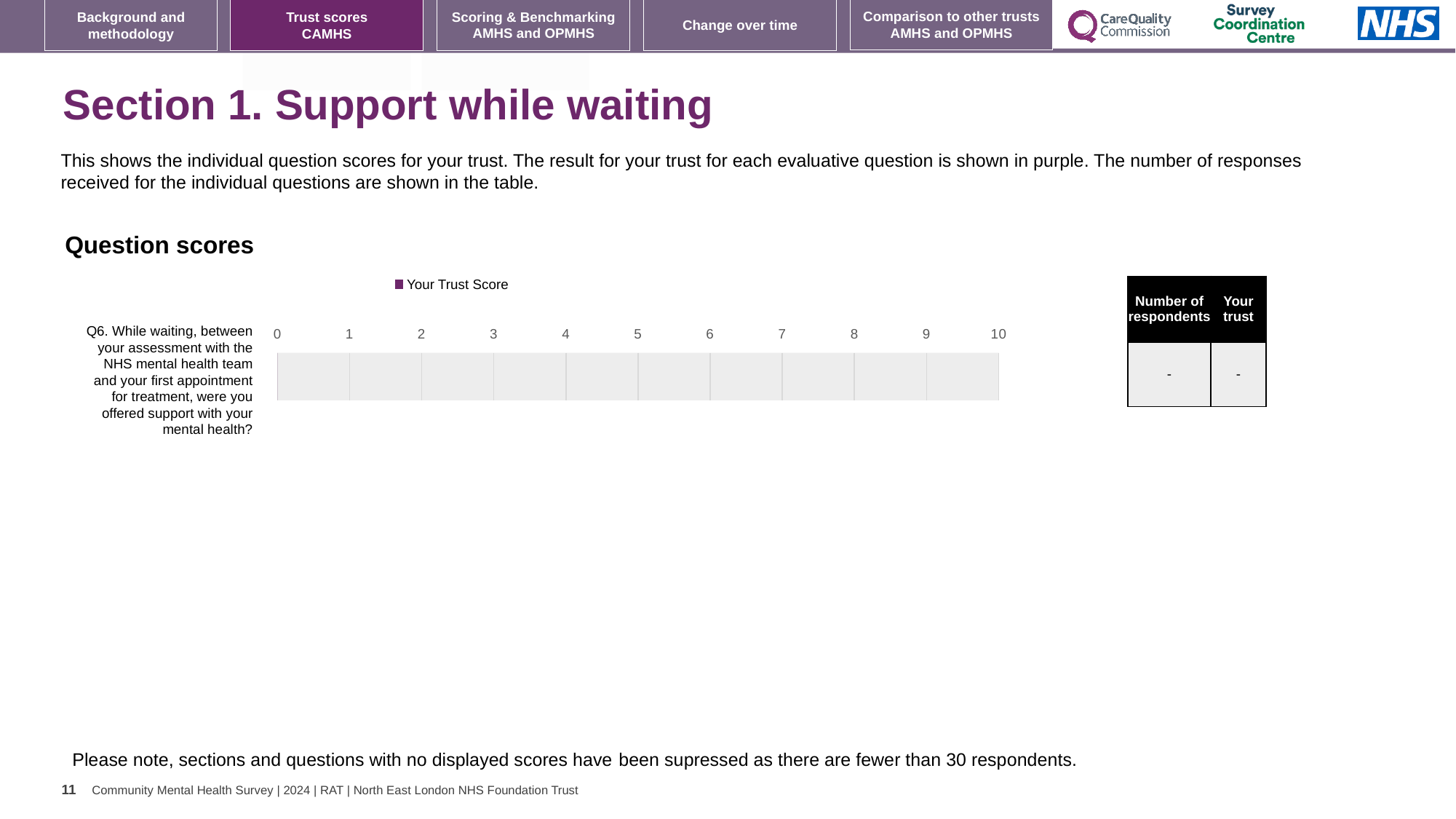
What is the name of the series in the legend of the "Question scores" chart? Your Trust Score Which question is listed on the "Question scores" chart? Q6. While waiting, between your assessment with the NHS mental health team and your first appointment for treatment, were you offered support with your mental health? How many series does the legend of the "Question scores" chart list? 1 What kind of chart is shown under "Question scores"? bar chart What is the maximum value shown on the x axis of the "Question scores" chart? 10 How many questions (categories) are shown on the "Question scores" chart? 1